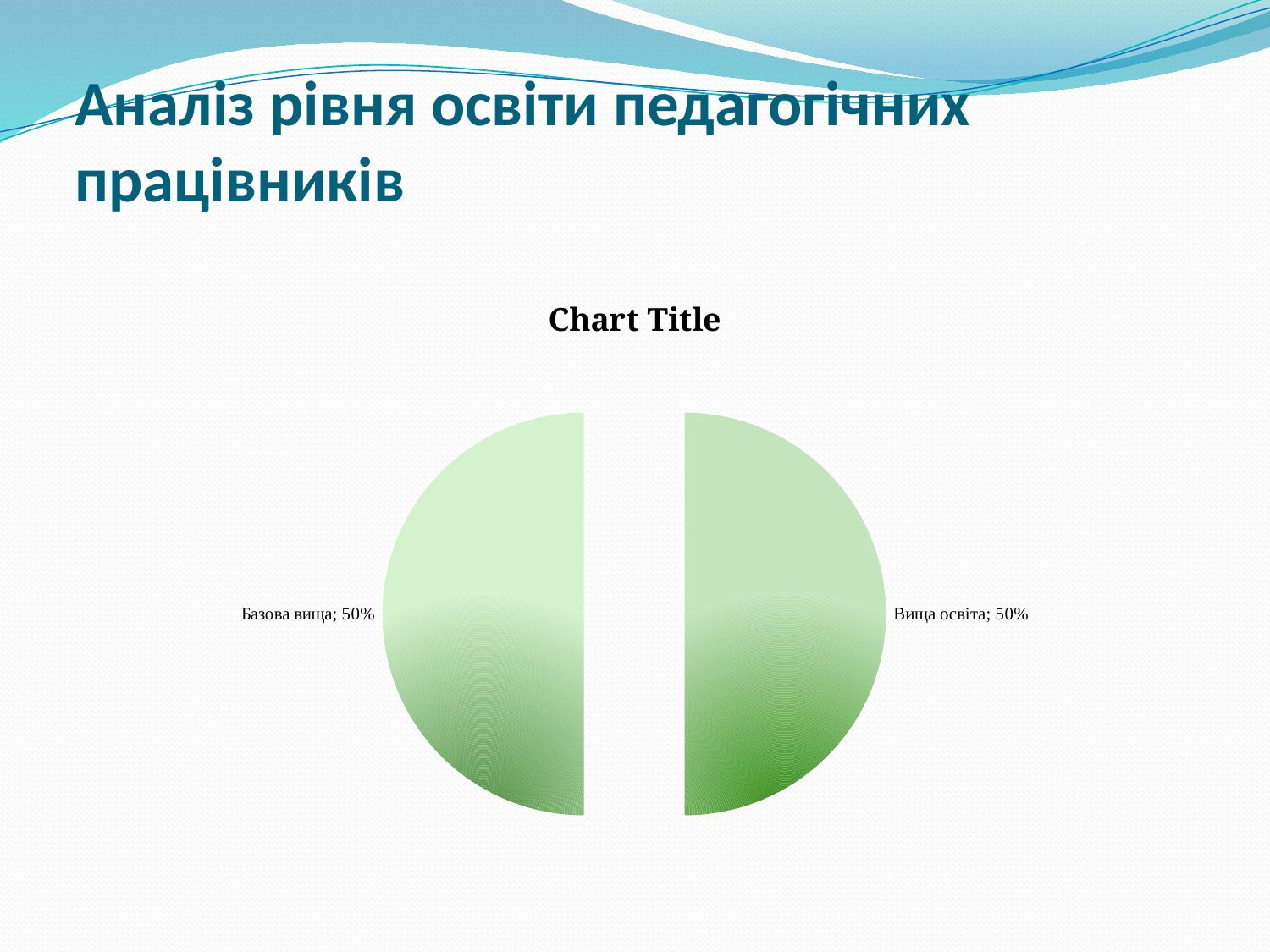
What share of the pie does "Базова вища" represent? 50% What kind of chart is shown on the slide? pie chart How many slices does the pie chart have? 2 Which category labels appear on the pie chart? Базова вища and Вища освіта What is the difference between the shares of "Вища освіта" and "Базова вища"? 0% What is the title shown above the pie chart? Chart Title What share of the pie does "Вища освіта" represent? 50% What is the combined share of "Базова вища" and "Вища освіта"? 100%